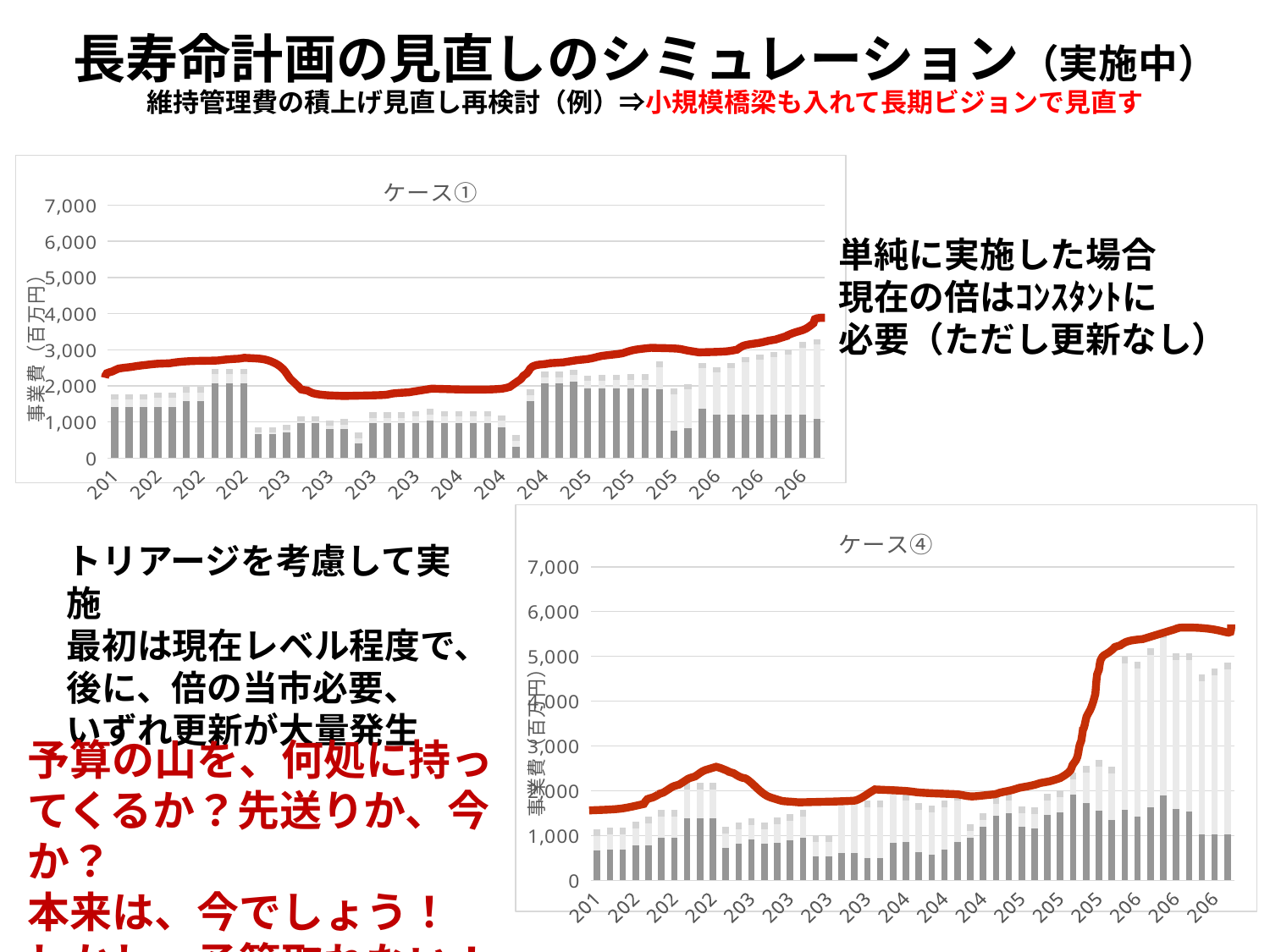
In the chart titled ケース①, is the lowest point of the red line greater or less than 2,000? less In the chart titled ケース④, what is the highest value shown on the vertical axis? 7,000 Which chart has the higher red-line value at its far right end, ケース① or ケース④? ケース④ In the chart titled ケース①, is the value of the red line at the far right end greater or less than 3,000? greater What is the title of the chart in the lower right of the slide? ケース④ In the chart titled ケース①, what is the label on the vertical axis? 事業費（百万円） In the chart titled ケース④, is the value of the red line at the far right end greater or less than 5,000? greater How many charts are shown on the slide? 2 In the chart titled ケース④, does the red line overall rise or fall from left to right? rise What kind of chart is the chart titled ケース①? bar chart with a line overlay